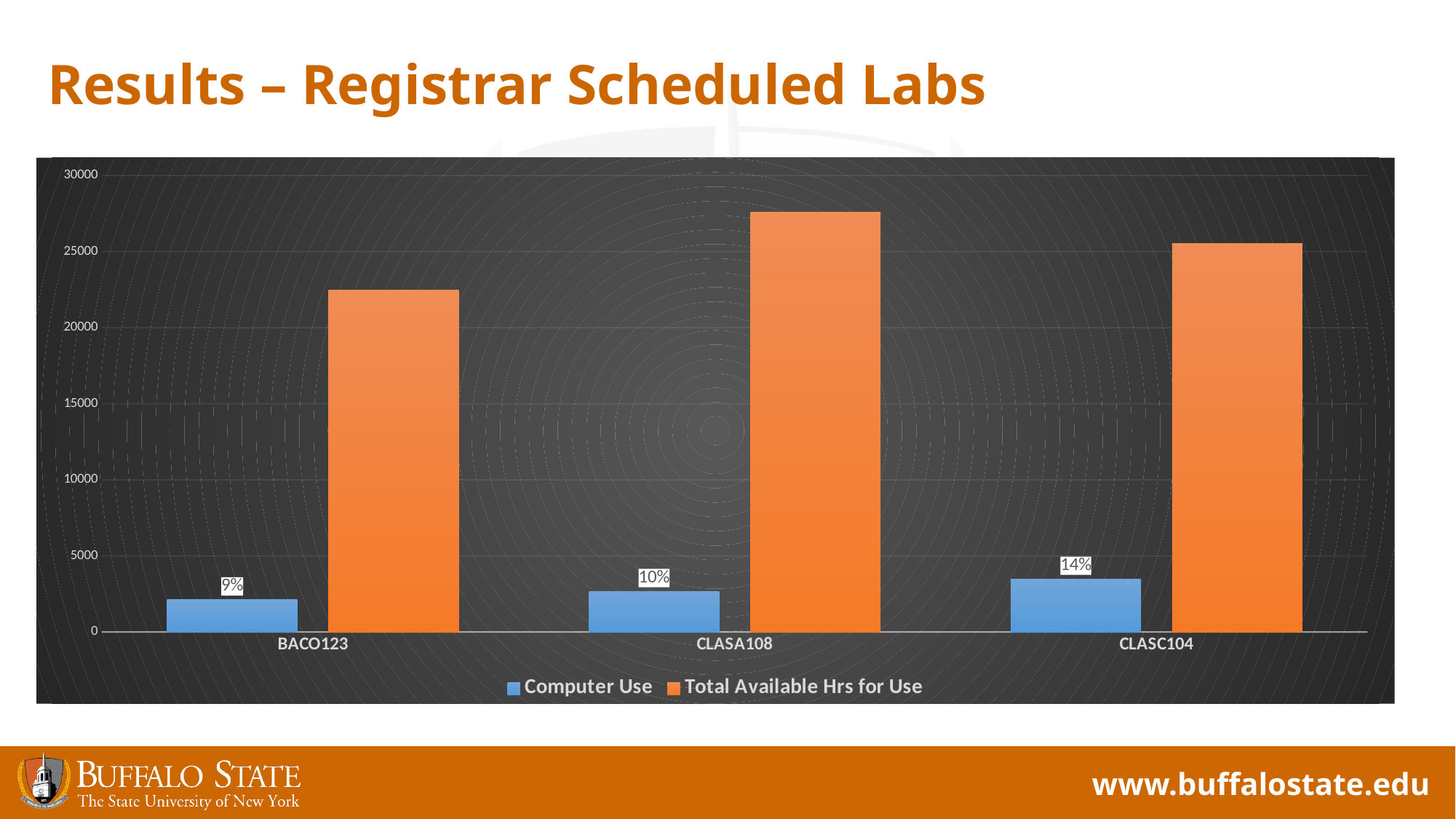
Is the Computer Use value for CLASC104 greater or less than 5000? less How many series does the chart legend list? 2 Which category has the lowest Total Available Hrs for Use? BACO123 How many categories are shown on the x axis of the chart? 3 What kind of chart is shown on the slide? bar chart Which category has the lowest Computer Use? BACO123 Which category has the highest Total Available Hrs for Use? CLASA108 Do the Computer Use values rise or fall from BACO123 to CLASC104? rise What label is printed on the Computer Use bar for CLASC104? 14% Which is larger: Total Available Hrs for Use for CLASC104 or for BACO123? CLASC104 What label is printed on the Computer Use bar for BACO123? 9% Is the Total Available Hrs for Use value for CLASA108 greater or less than 25000? greater